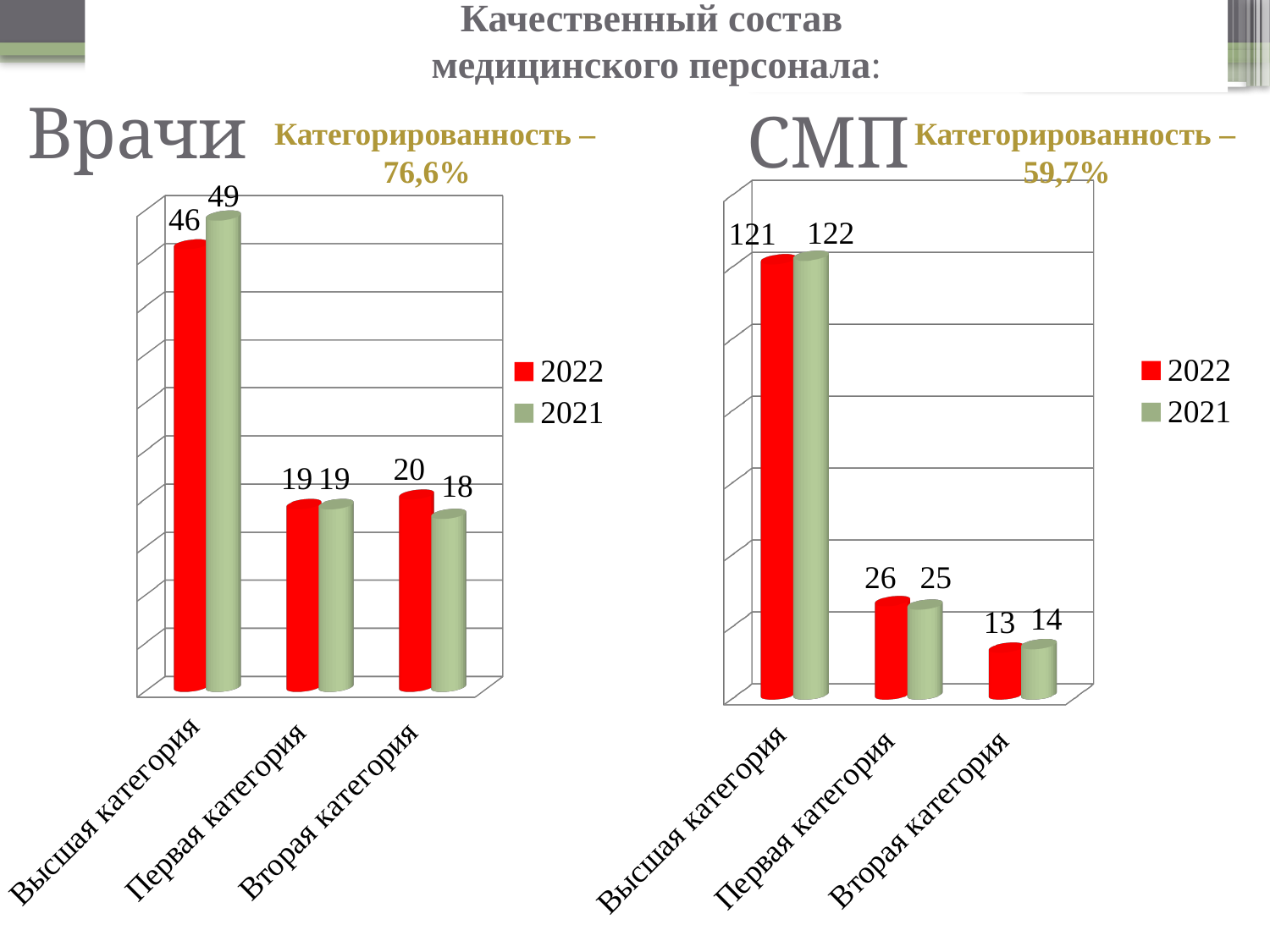
In the СМП chart, what is the value for Первая категория in 2022? 26 How many series does the legend of the Врачи chart list? 2 In the Врачи chart, what is the value for Высшая категория in 2022? 46 In the СМП chart, what is the value for Высшая категория in 2021? 122 How many categories are shown on the x axis of the СМП chart? 3 In the СМП chart, what is the difference between the 2022 and 2021 values for Вторая категория? 1 In the Врачи chart, what is the value for Вторая категория in 2021? 18 In the Врачи chart, what is the difference between the 2021 and 2022 values for Высшая категория? 3 What type of chart is the СМП chart? Bar chart In the Врачи chart, which category has the highest value for 2021? Высшая категория In the Врачи chart, which is larger for Вторая категория: the 2022 value or the 2021 value? 2022 In the СМП chart, which category has the lowest value for 2022? Вторая категория